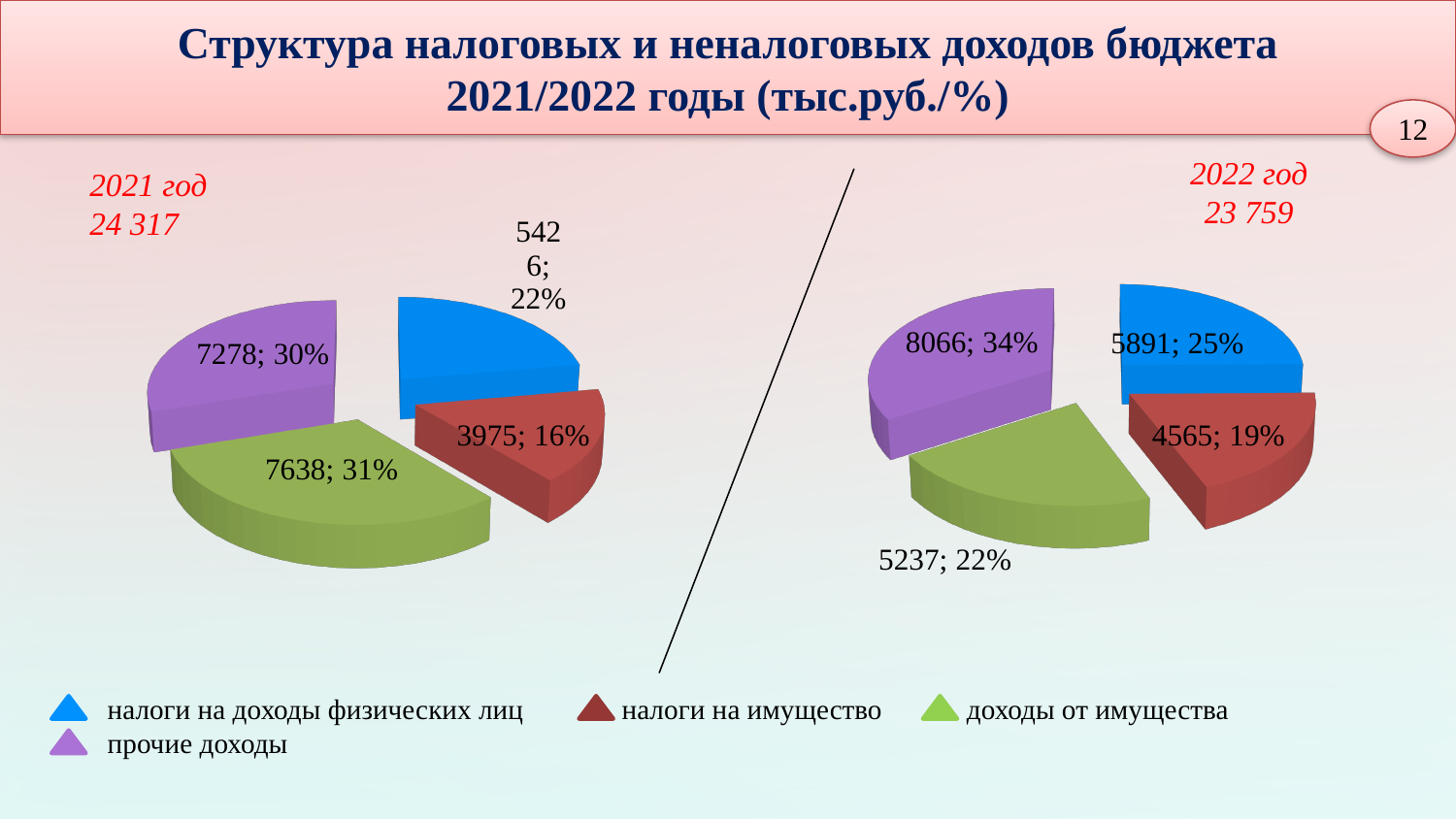
In the 2021 год pie chart, what share of the pie does налоги на доходы физических лиц take? 22% In the 2022 год pie chart, what is the difference between the values for прочие доходы and налоги на имущество? 3501 In the 2021 год pie chart, which category has the smallest slice? налоги на имущество In the 2022 год pie chart, what share of the pie does доходы от имущества take? 22% What type of charts are shown on the slide? pie charts In the 2021 год pie chart, what is the value for налоги на имущество? 3975; 16% Which is larger: налоги на имущество in 2021 год or налоги на имущество in 2022 год? 2022 год In the 2022 год pie chart, what is the value for налоги на доходы физических лиц? 5891; 25% How many categories does the legend list? 4 In the 2022 год pie chart, which category has the largest slice? прочие доходы In the 2021 год pie chart, what is the value for доходы от имущества? 7638; 31% In the 2022 год pie chart, what is the value for прочие доходы? 8066; 34%